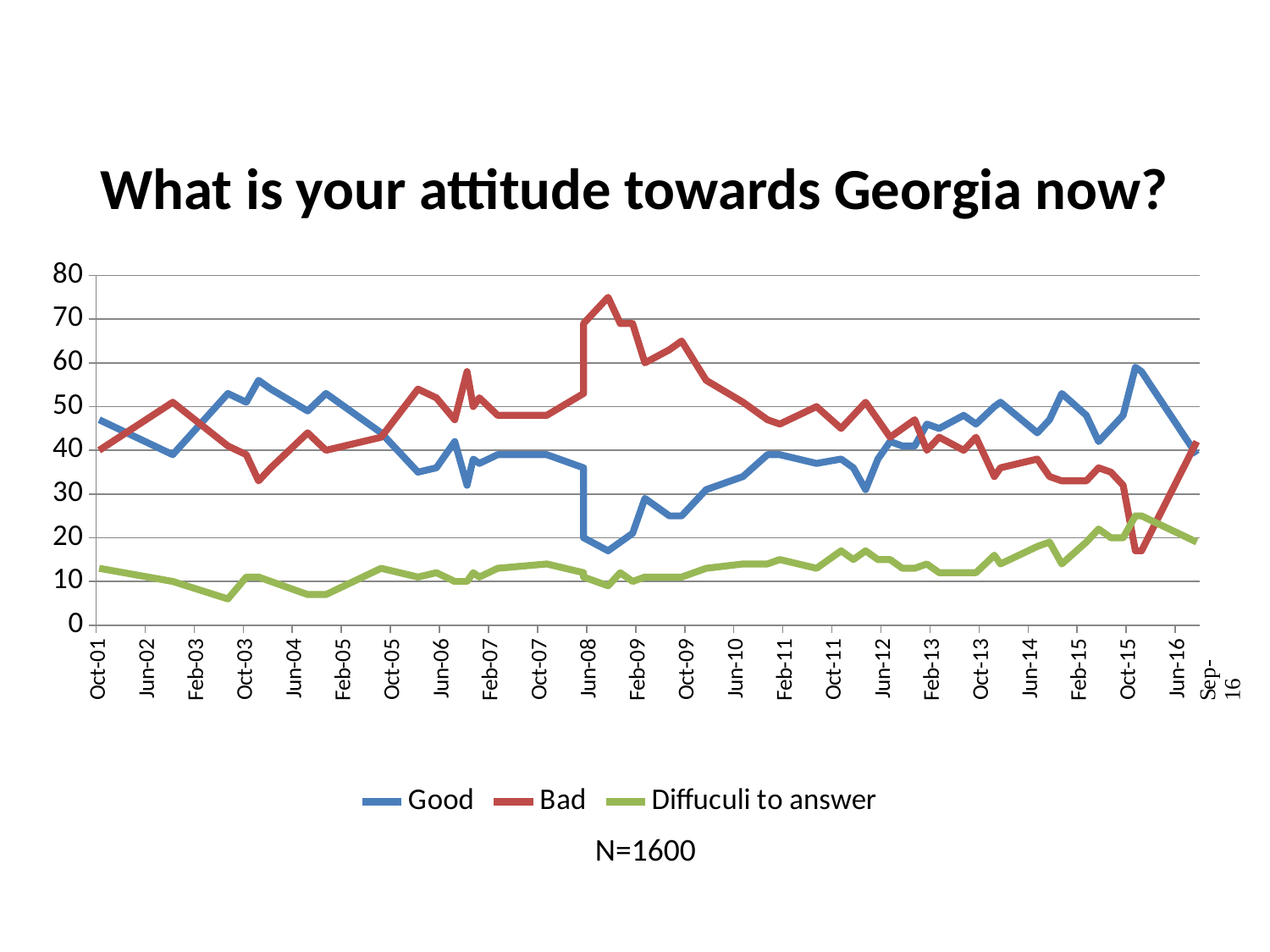
Is the value for Good at Oct-01 greater or less than 40? greater How many series does the legend list? 3 Which series is drawn in green according to the legend? Diffuculi to answer Is the value for Diffuculi to answer at Oct-01 greater or less than 20? less Which series reaches the highest value anywhere on the chart? Bad What is the title of the chart? What is your attitude towards Georgia now? At Oct-03, which series is higher, Good or Bad? Good Is the peak value of the Bad series around Jun-08 greater or less than 70? greater At Jun-08, which series is higher, Good or Bad? Bad What kind of chart is shown on the slide? line chart